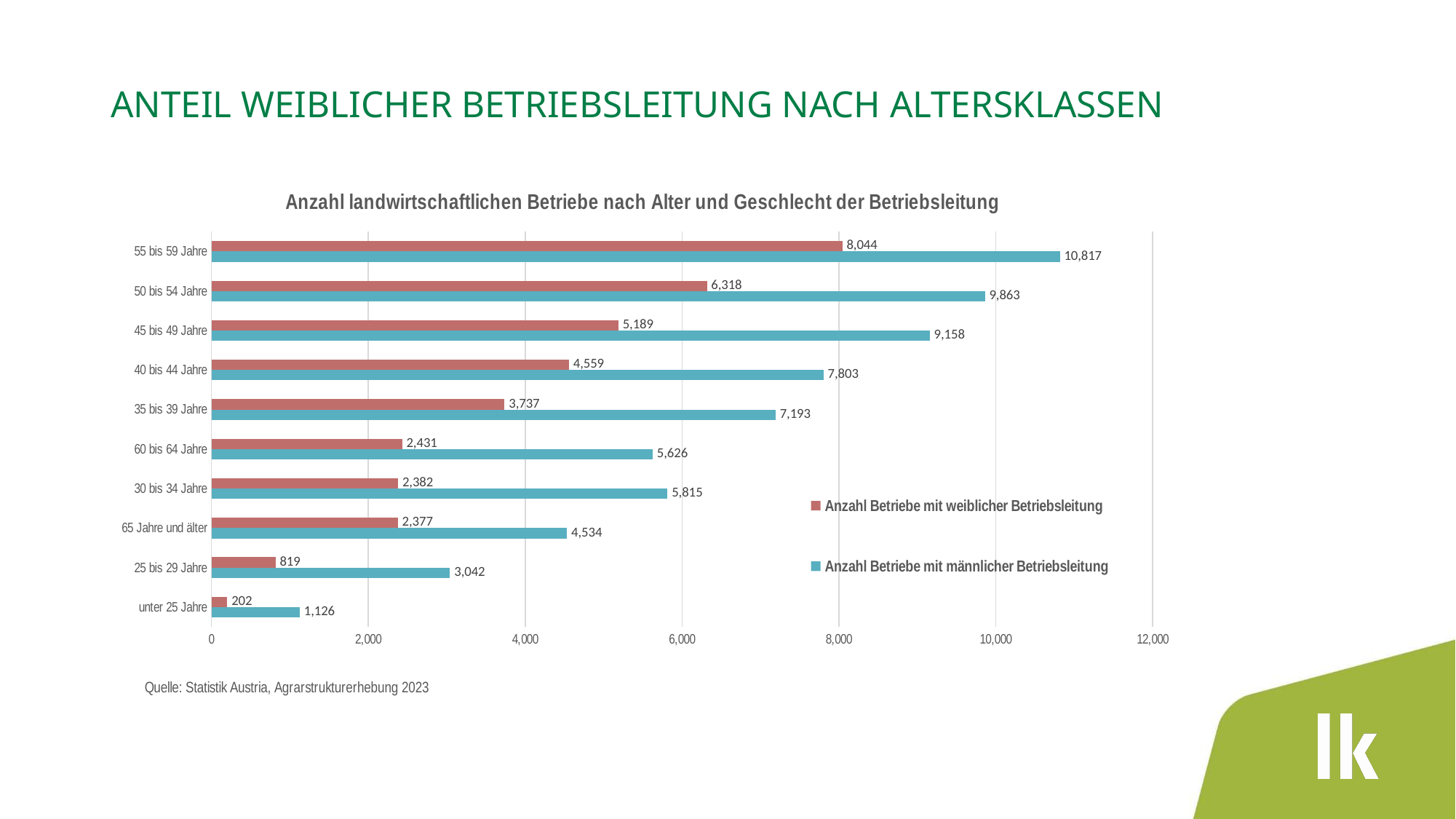
Which age group has the lowest number of farms with female management? unter 25 Jahre What is the value for 'unter 25 Jahre' in the series Anzahl Betriebe mit weiblicher Betriebsleitung? 202 Which age group has the highest number of farms with male management? 55 bis 59 Jahre What is the number of farms with male management (Anzahl Betriebe mit männlicher Betriebsleitung) for the age group 45 bis 49 Jahre? 9,158 How many series does the legend list? 2 Is the value for male-managed farms in the age group 40 bis 44 Jahre greater or less than 8,000? less What is the title of the chart? Anzahl landwirtschaftlichen Betriebe nach Alter und Geschlecht der Betriebsleitung What is the number of farms with female management (Anzahl Betriebe mit weiblicher Betriebsleitung) for the age group 55 bis 59 Jahre? 8,044 How many age groups are shown on the chart? 10 What kind of chart is shown on the slide? bar chart Which is larger: the number of female-managed farms for 60 bis 64 Jahre or for 30 bis 34 Jahre? 60 bis 64 Jahre What is the difference between male-managed and female-managed farms in the age group 50 bis 54 Jahre? 3,545